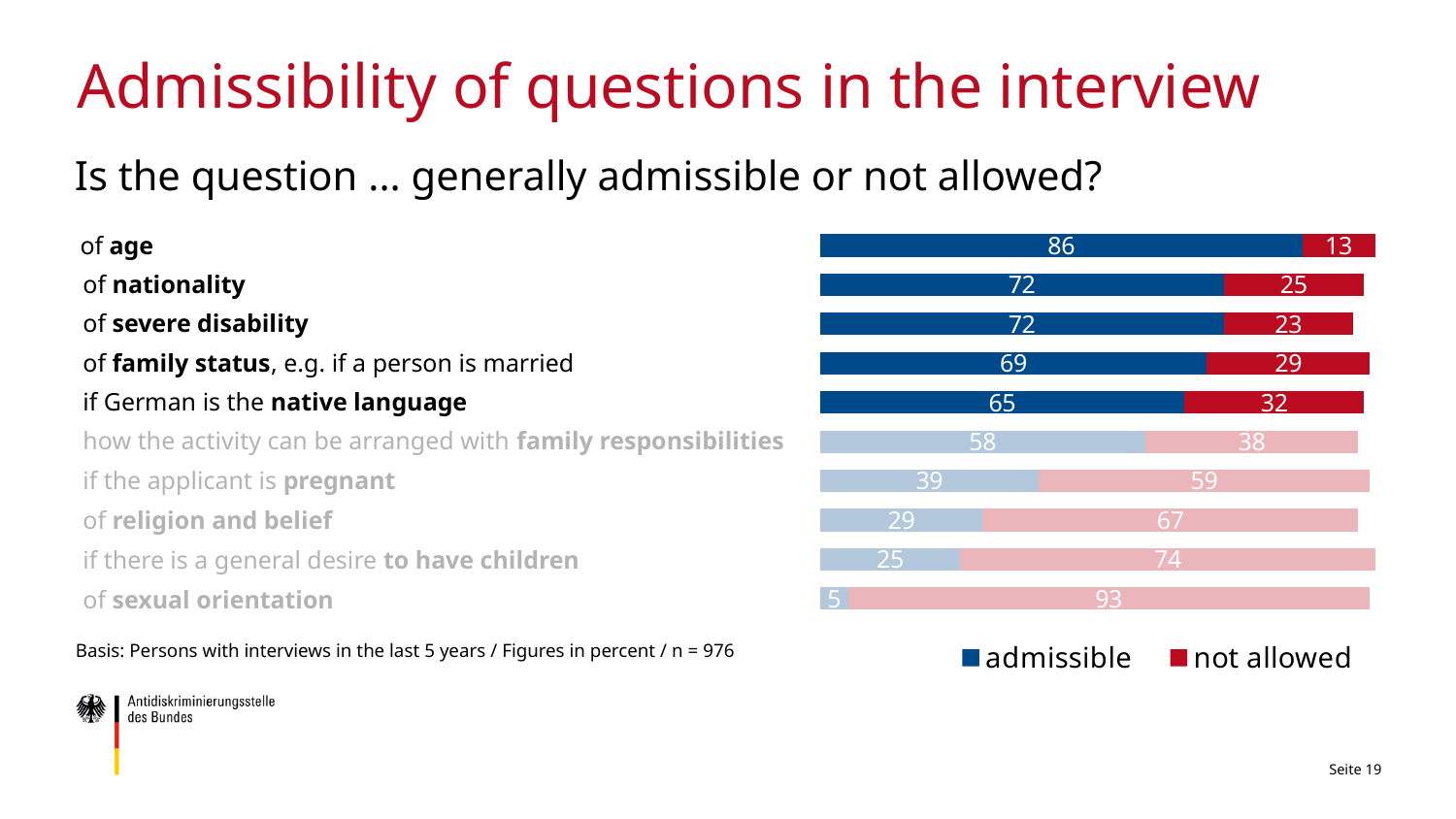
Is the 'admissible' value larger for the question of family status or for the question if German is the native language? of family status What is the 'not allowed' value for the question if the applicant is pregnant? 59 What percentage of respondents say a question of sexual orientation is not allowed? 93 Which category has the lowest 'admissible' value? of sexual orientation What is the total of the 'admissible' and 'not allowed' values for the question of nationality? 97 What percentage of respondents consider a question of age admissible? 86 Which category has the highest 'admissible' value? of age How many categories (questions) are shown in the chart? 10 How many series does the legend list? 2 What kind of chart is shown on the slide? stacked bar chart Which colour represents the 'not allowed' series in the legend? red What is the difference between the 'admissible' and 'not allowed' values for the question of religion and belief? 38